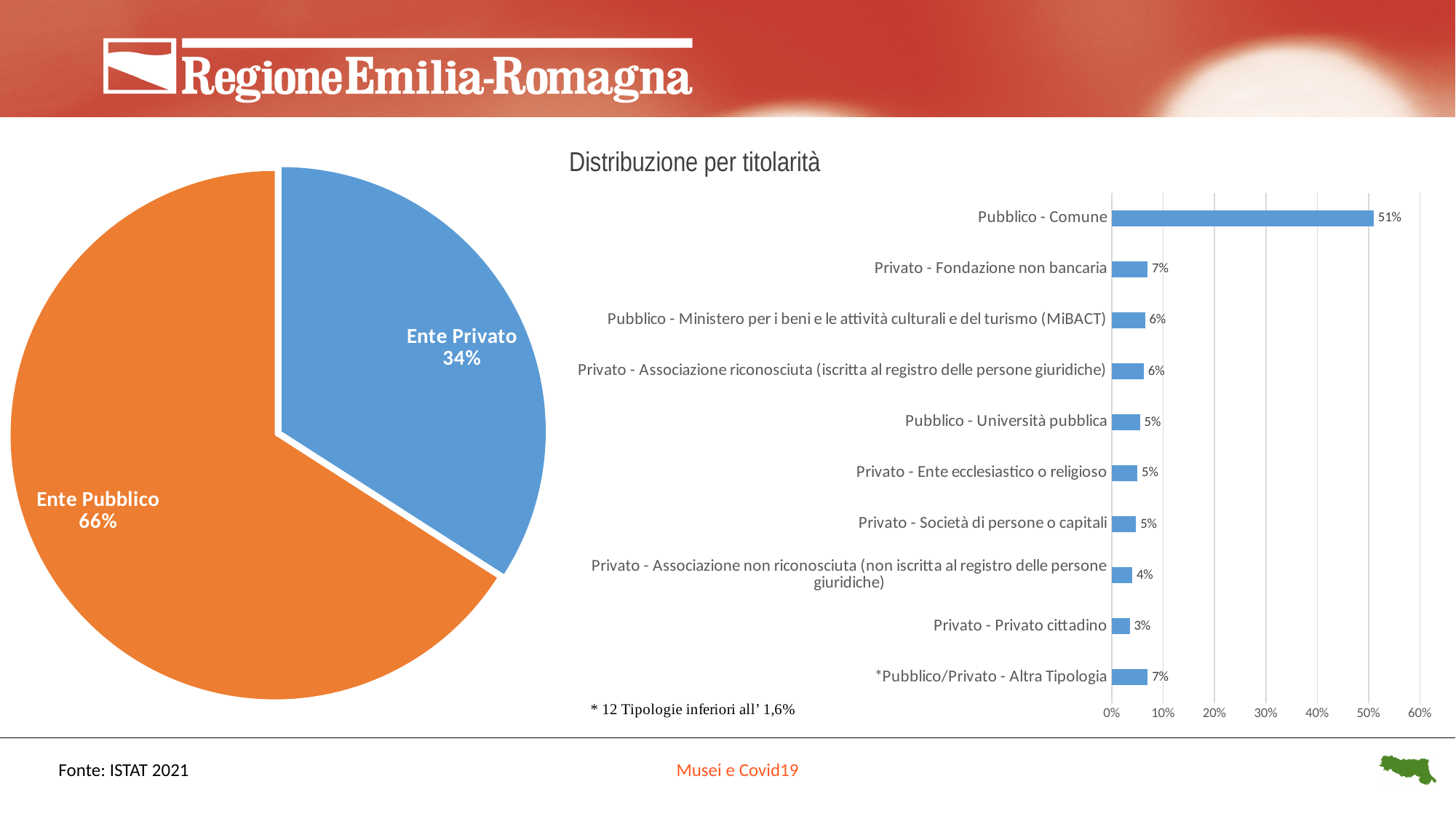
In 'Distribuzione per titolarità', which category has the highest value? Pubblico - Comune In 'Distribuzione per titolarità', which category has the lowest value? Privato - Privato cittadino What kind of chart is 'Distribuzione per titolarità'? Bar chart What kind of chart is the chart on the left of the slide? Pie chart In 'Distribuzione per titolarità', what is the value for Privato - Privato cittadino? 3% How many slices does the pie chart on the left have? 2 In 'Distribuzione per titolarità', what is the difference between Pubblico - Comune and Privato - Fondazione non bancaria? 44% In 'Distribuzione per titolarità', what is the value for Pubblico - Comune? 51% In the pie chart on the left, which slice is larger, Ente Pubblico or Ente Privato? Ente Pubblico In the pie chart on the left, what share does Ente Pubblico have? 66% How many categories are shown in 'Distribuzione per titolarità'? 10 In the pie chart on the left, what share does Ente Privato have? 34%